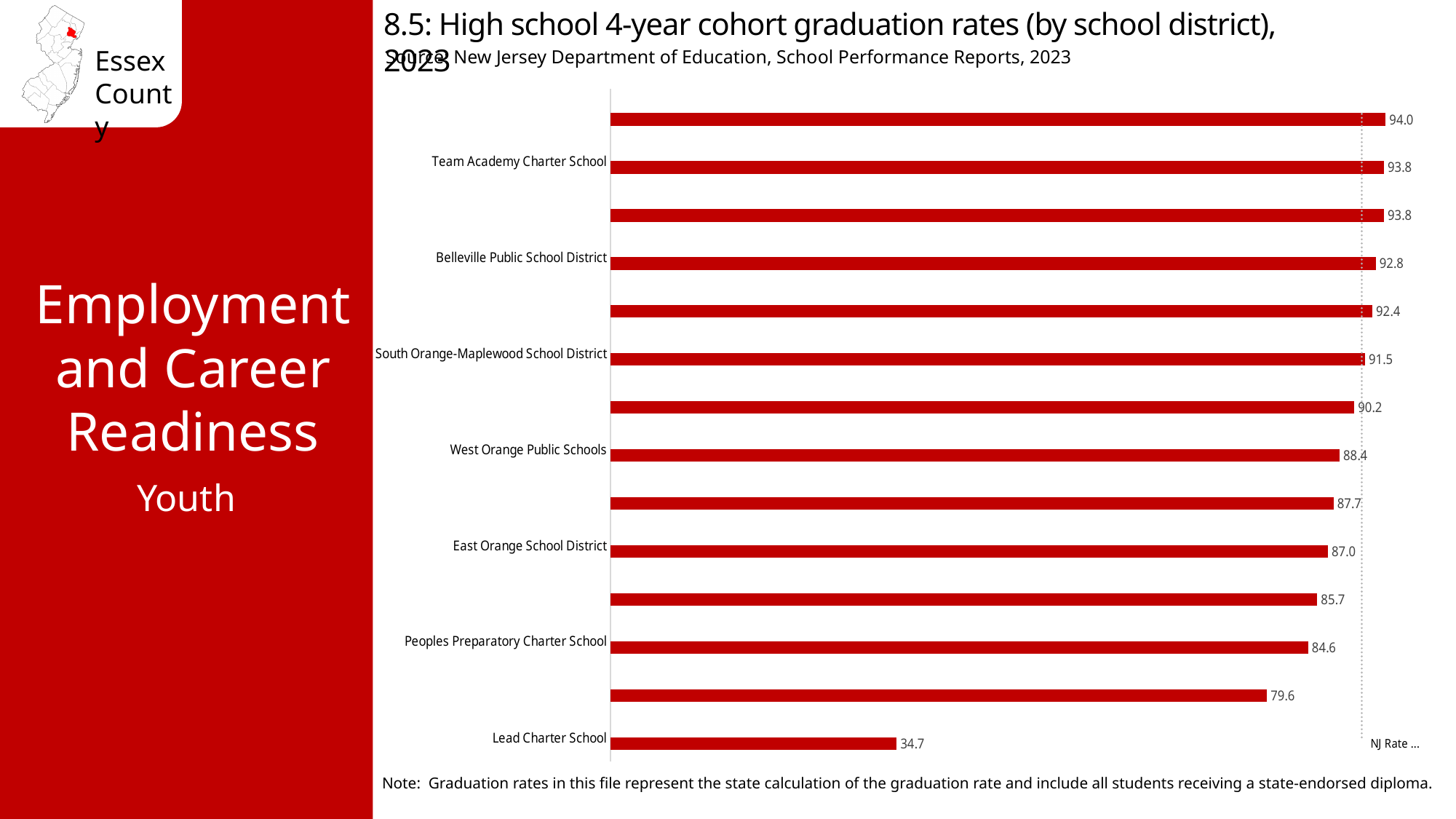
What is the graduation rate for West Orange Public Schools? 88.4 What is the graduation rate for Peoples Preparatory Charter School? 84.6 What is the graduation rate for East Orange School District? 87.0 What type of chart is shown on the slide? Bar chart What is the graduation rate for Belleville Public School District? 92.8 What is the highest graduation rate value shown on the chart? 94.0 What is the graduation rate for Team Academy Charter School? 93.8 What is the difference between the graduation rates of Belleville Public School District and Lead Charter School? 58.1 What is the graduation rate for South Orange-Maplewood School District? 91.5 Which labeled school district has the lowest graduation rate? Lead Charter School How many bars are plotted on the chart? 14 Which has a higher graduation rate, West Orange Public Schools or East Orange School District? West Orange Public Schools